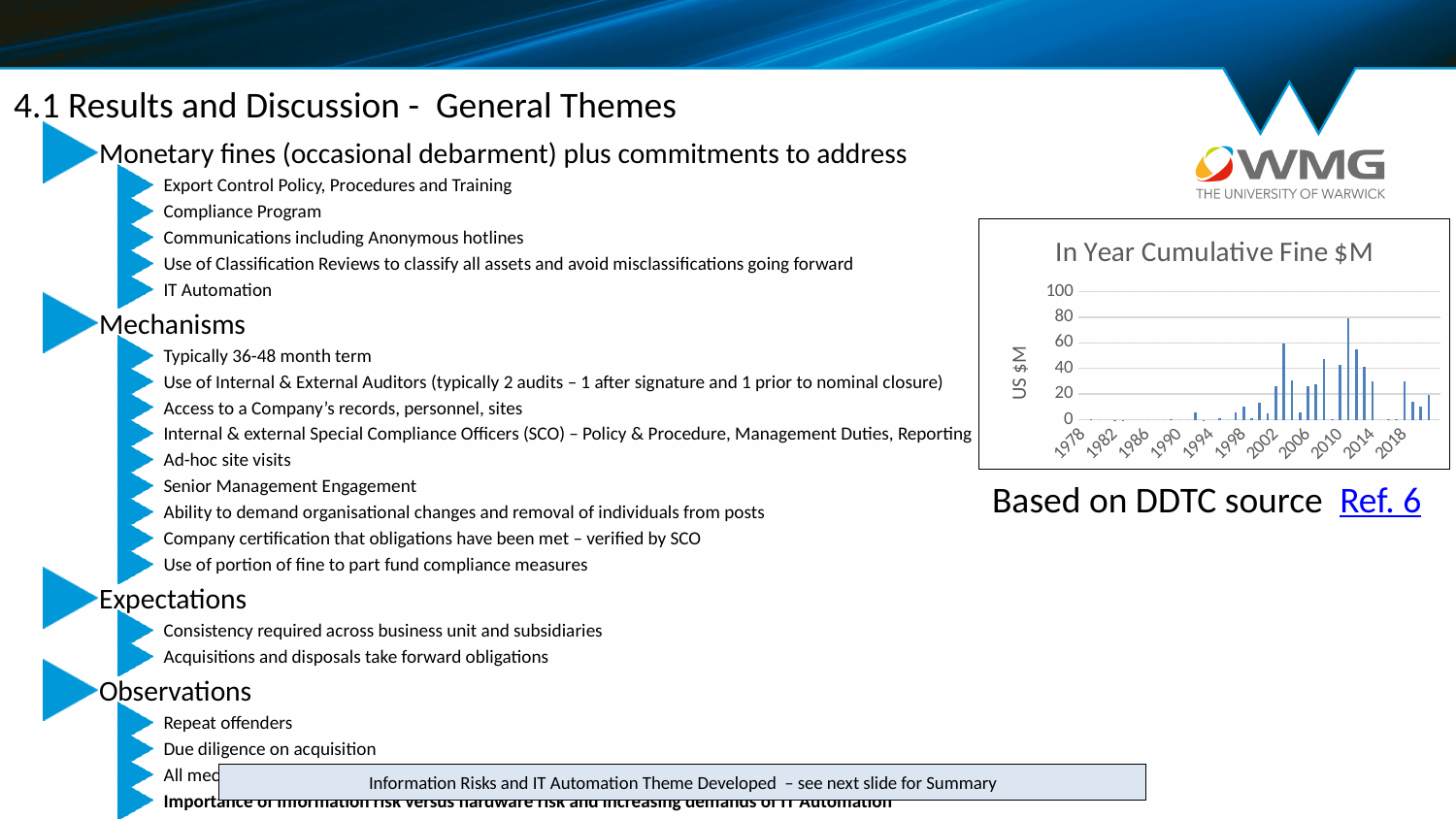
How many year labels are shown along the x axis of the chart? 11 What is the title of the chart on the slide? In Year Cumulative Fine $M Are the fines in the chart generally higher in the 2000s or in the 1980s? 2000s Is the tallest bar in the chart greater or less than 100? less Is the value for 1990 greater or less than 20? less Is the value for 1994 greater or less than 20? less What is the label on the y axis of the chart? US $M What kind of chart is shown on the slide? bar chart